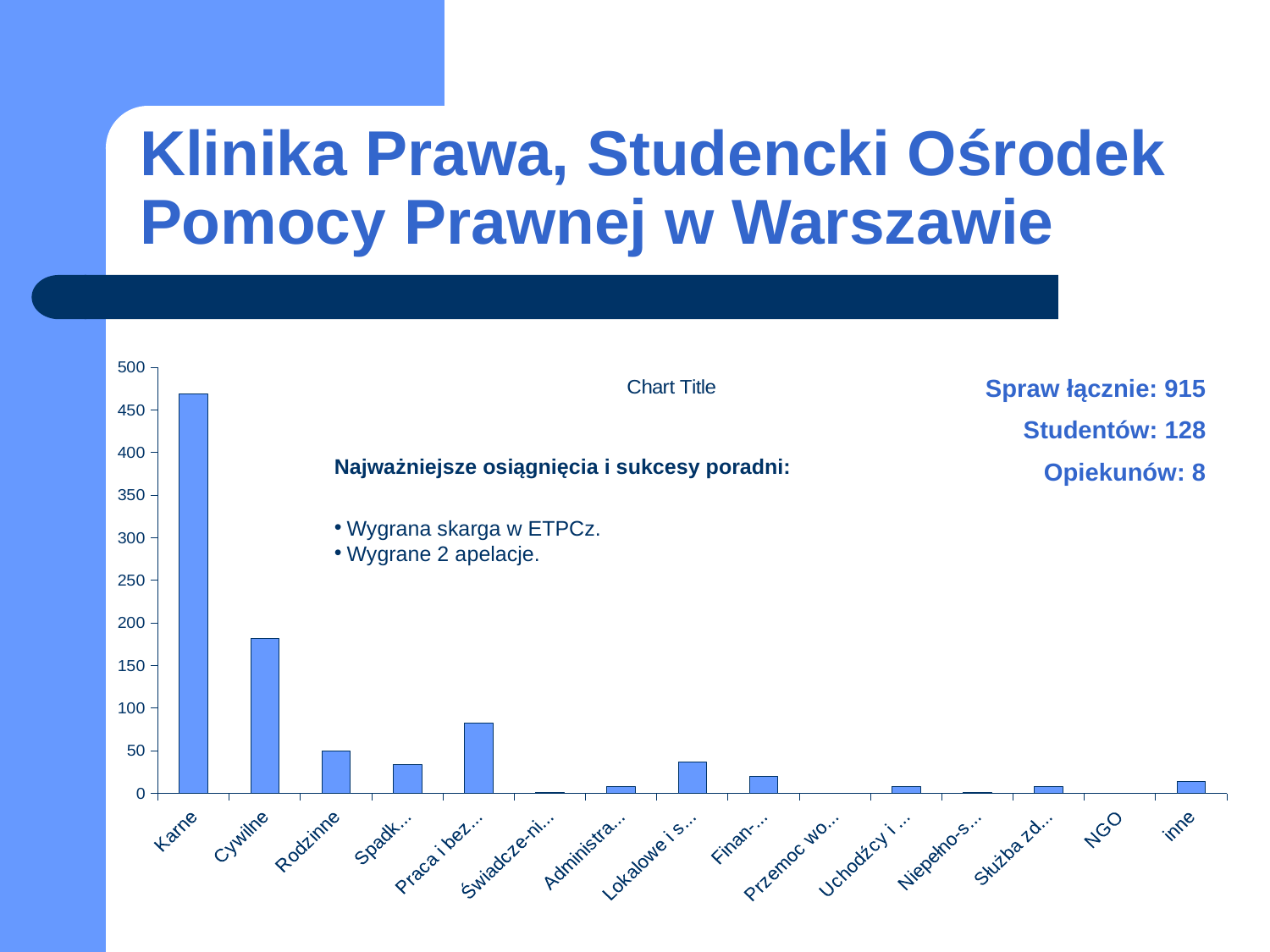
Which is larger, the value for Lokalowe i s... or the value for Finan-...? Lokalowe i s... What kind of chart is shown on the slide? bar chart Is the value for Praca i bez... greater or less than 50? greater What is the title shown on the chart? Chart Title Which is larger, the value for Praca i bez... or the value for Rodzinne? Praca i bez... Is the value for Praca i bez... greater or less than 100? less Is the value for Cywilne greater or less than 200? less Which is larger, the value for Karne or the value for Cywilne? Karne How many categories are plotted on the x axis of the chart? 15 Which category has the highest bar in the chart? Karne